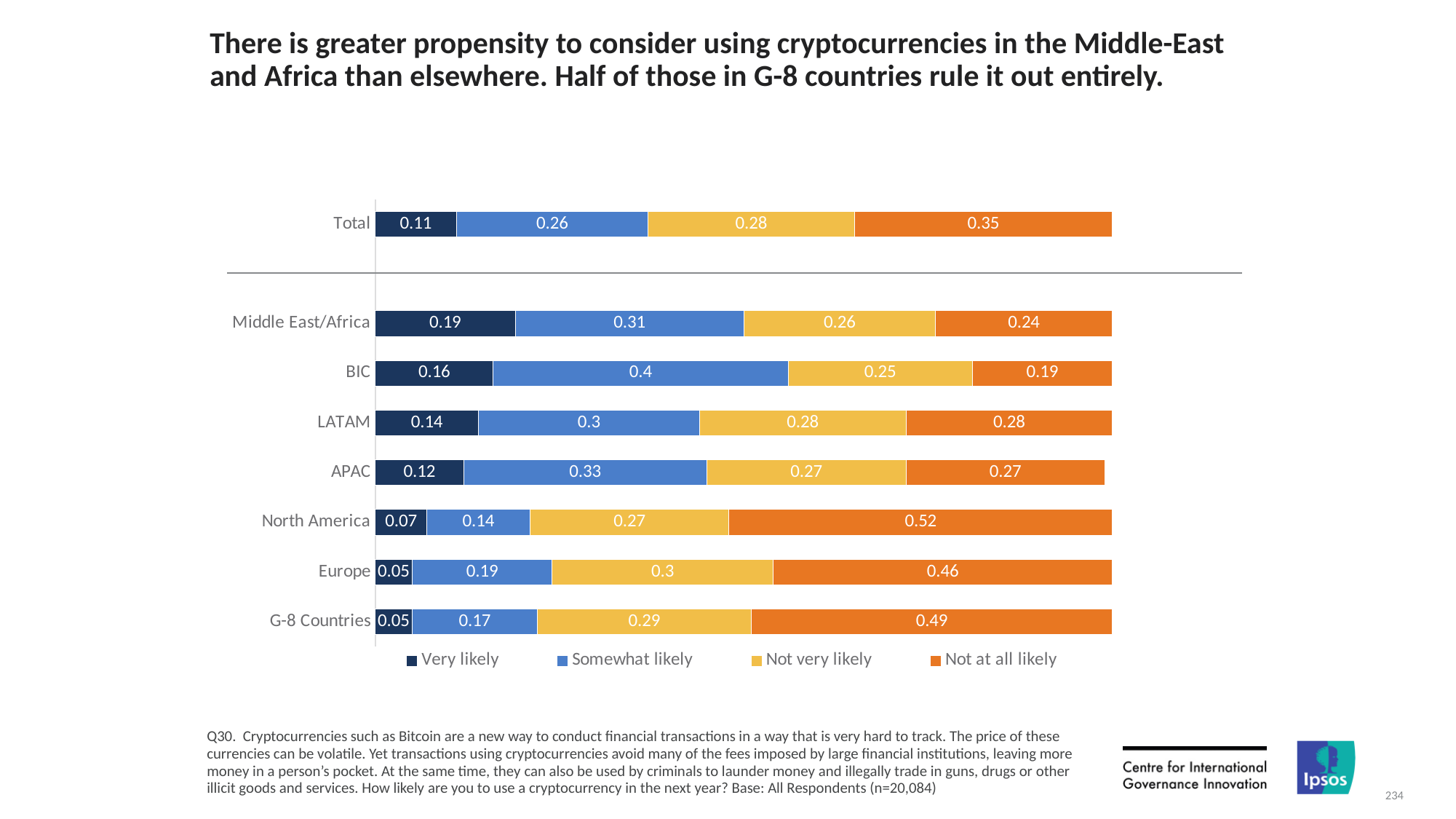
Which is larger, the 'Somewhat likely' value for APAC or for LATAM? APAC How many regions (excluding Total) are shown in the chart? 7 What is the 'Not at all likely' value for North America? 0.52 What is the total of the stacked bar for G-8 Countries? 1 What is the 'Very likely' value for Middle East/Africa? 0.19 How many series does the legend list? 4 What kind of chart is shown on the slide? Stacked bar chart Which region has the highest 'Very likely' value? Middle East/Africa What is the 'Somewhat likely' value for BIC? 0.4 Which region has the lowest 'Not at all likely' value? BIC What is the difference between the 'Not at all likely' values for North America and Middle East/Africa? 0.28 What is the 'Not very likely' value for Europe? 0.3